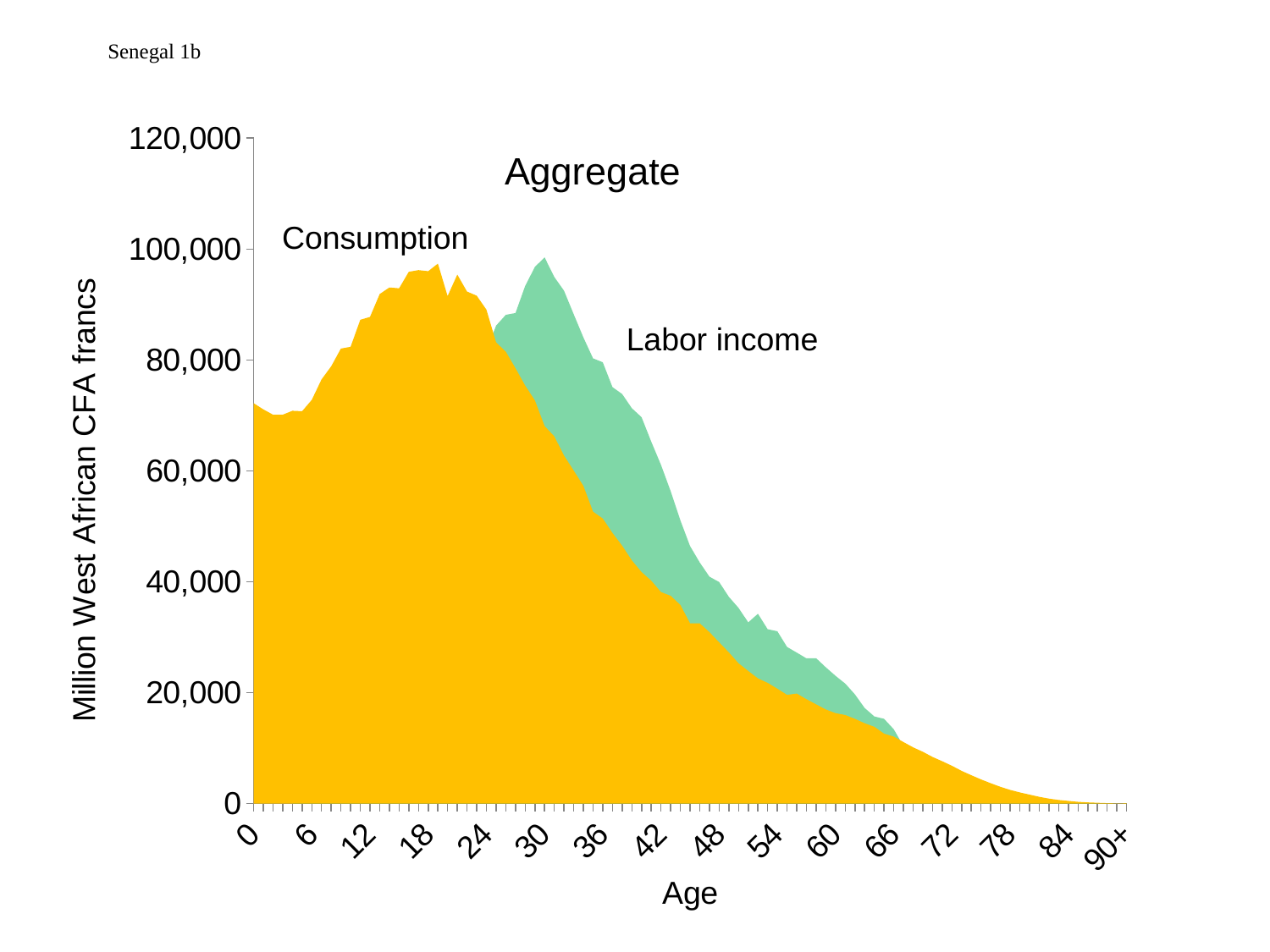
Is the value of Consumption at age 60 greater or less than 20,000? less At age 12, which is larger, Consumption or Labor income? Consumption Is the peak value of Consumption greater or less than 100,000? less Is the peak value of Labor income greater or less than 80,000? greater What kind of chart is shown on the slide? Area chart What is the label of the vertical axis? Million West African CFA francs What is the title of the chart? Aggregate At age 30, which is larger, Labor income or Consumption? Labor income Does Consumption rise or fall from age 24 to age 90+? Fall How many series are plotted in the chart? 2